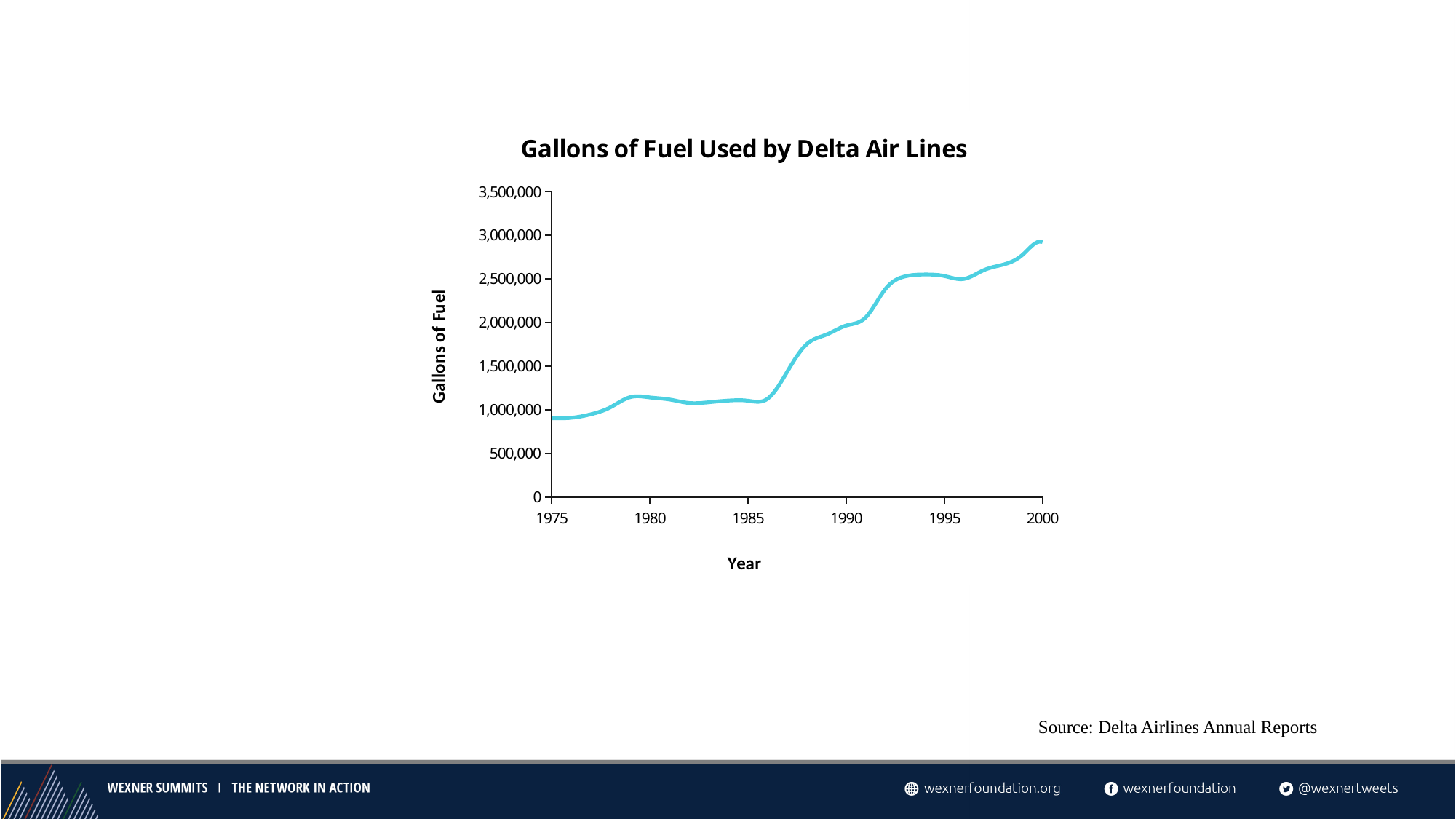
Is the value for 1975 greater or less than 1,000,000? less Overall, do the values rise or fall from 1975 to 2000? rise What kind of chart is shown on the slide? line chart Is the value for 2000 greater or less than 2,500,000? greater Is the value for 1995 greater or less than 2,000,000? greater What is the label on the vertical axis of the chart? Gallons of Fuel Which year has the larger value, 1985 or 1995? 1995 In which year shown on the x axis is the value lowest? 1975 What is the title of the chart? Gallons of Fuel Used by Delta Air Lines In which year shown on the x axis is the value highest? 2000